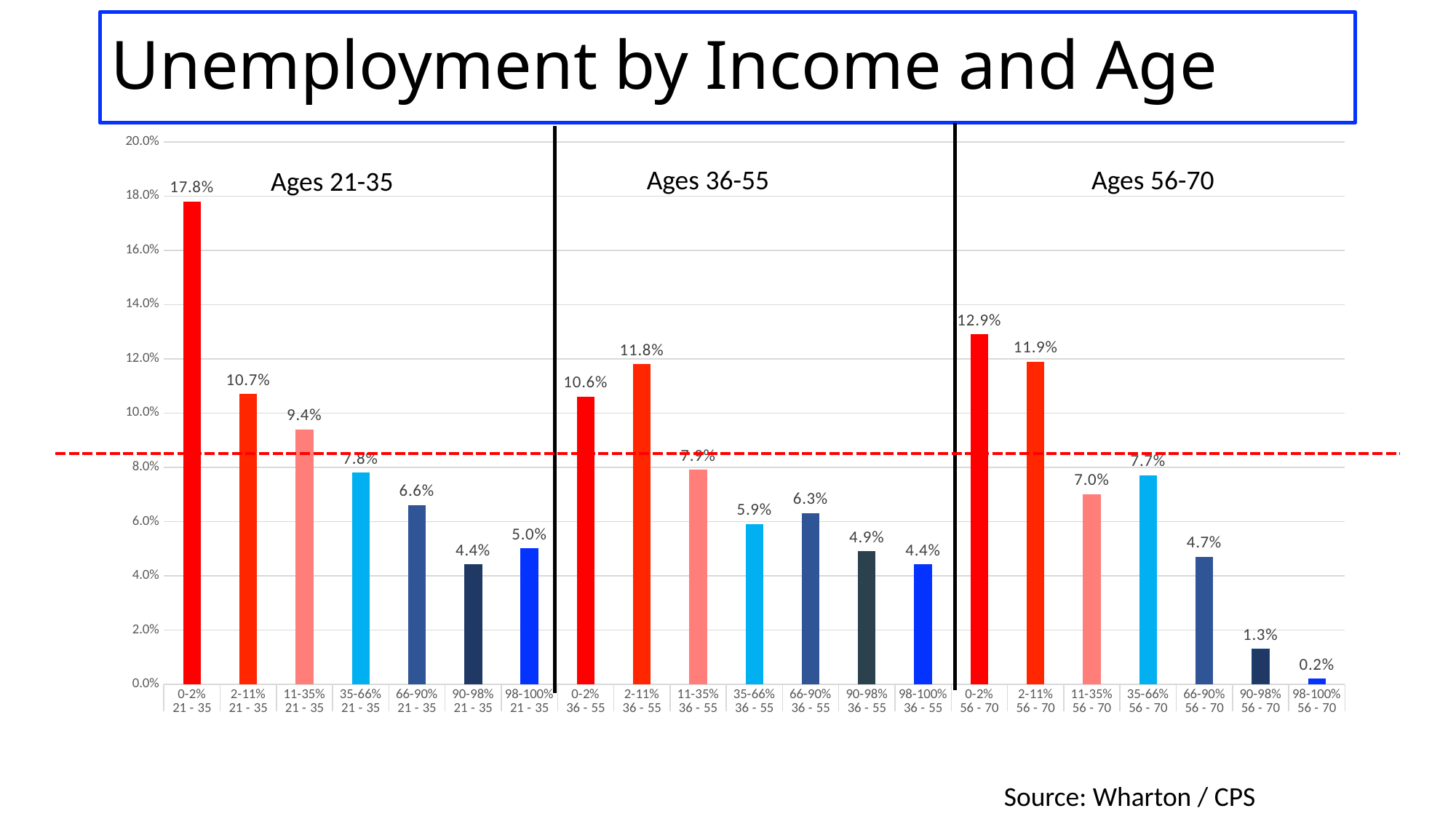
How many bars are plotted on the chart? 21 What is the difference between the unemployment rates of the 0-2% and 2-11% income groups for ages 56-70? 1.0% What is the unemployment rate for the 0-2% income group, ages 21-35? 17.8% What source is cited for the chart? Wharton / CPS What kind of chart is shown on the slide? Bar chart Within ages 36-55, which has the higher unemployment rate: the 0-2% income group or the 2-11% income group? 2-11% What is the unemployment rate for the 98-100% income group, ages 56-70? 0.2% What is the unemployment rate for the 66-90% income group, ages 36-55? 6.3% What is the difference between the unemployment rate of the 0-2% income group for ages 21-35 and the 0-2% income group for ages 36-55? 7.2% Which bar has the lowest unemployment rate on the chart? 98-100%, 56-70 What is the title of the slide? Unemployment by Income and Age Which bar has the highest unemployment rate on the chart? 0-2%, 21-35